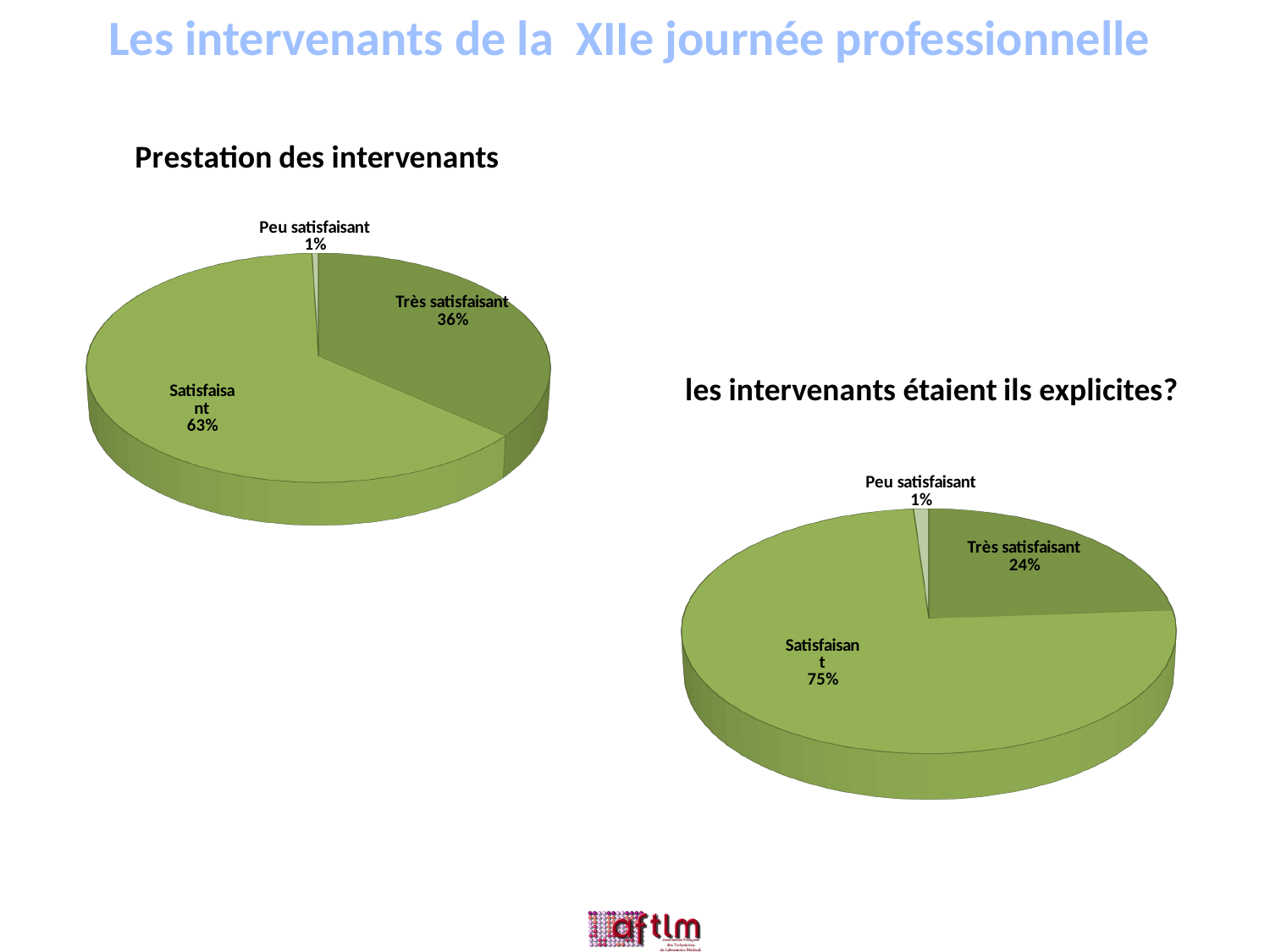
In the 'Prestation des intervenants' chart, what share is labelled for Très satisfaisant? 36% How many slices does the 'les intervenants étaient ils explicites?' chart have? 3 In the 'les intervenants étaient ils explicites?' chart, what share is labelled for Très satisfaisant? 24% In the 'Prestation des intervenants' chart, which category has the smallest slice? Peu satisfaisant In the 'Prestation des intervenants' chart, what is the difference between the Satisfaisant and Très satisfaisant shares? 27% In the 'les intervenants étaient ils explicites?' chart, which category has the largest slice? Satisfaisant In the 'Prestation des intervenants' chart, which category has the largest slice? Satisfaisant In the 'Prestation des intervenants' chart, what share is labelled for Peu satisfaisant? 1% In the 'Prestation des intervenants' chart, what share is labelled for Satisfaisant? 63% In the 'les intervenants étaient ils explicites?' chart, what is the difference between the Satisfaisant and Très satisfaisant shares? 51% What kind of chart is 'Prestation des intervenants'? Pie chart In the 'les intervenants étaient ils explicites?' chart, what share is labelled for Satisfaisant? 75%